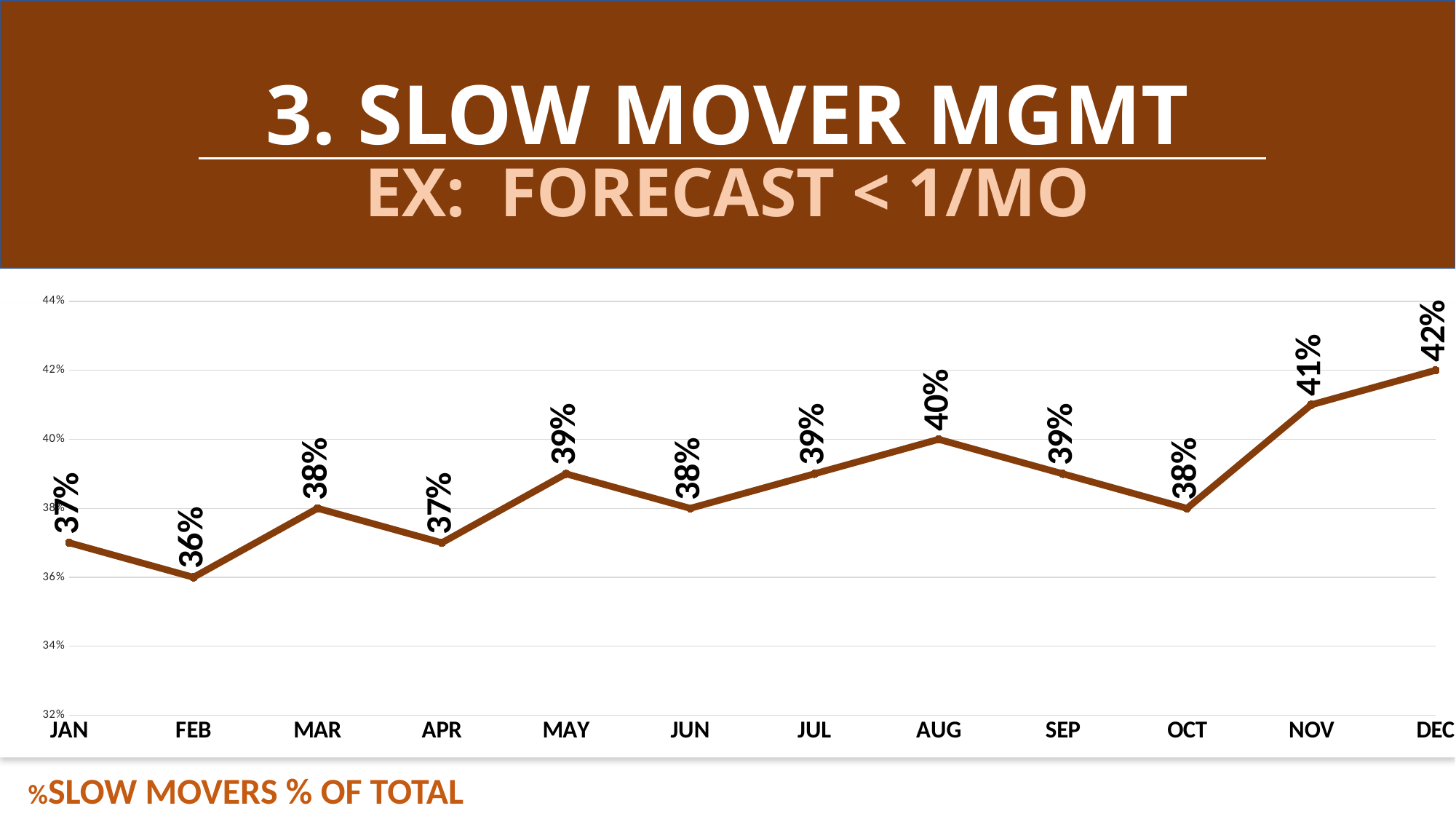
What is the value for NOV? 41% Is the value for NOV greater or less than 40%? greater What kind of chart is shown? line chart What is the value for AUG? 40% What is the difference between the DEC value and the JAN value? 5% How many months are plotted on the x axis? 12 Which is larger, the value for MAY or the value for OCT? MAY What is the label shown below the chart describing the plotted series? %SLOW MOVERS % OF TOTAL What is the value for FEB? 36% Which month has the highest value? DEC Which month has the lowest value? FEB Do the values generally rise or fall from JAN to DEC? rise